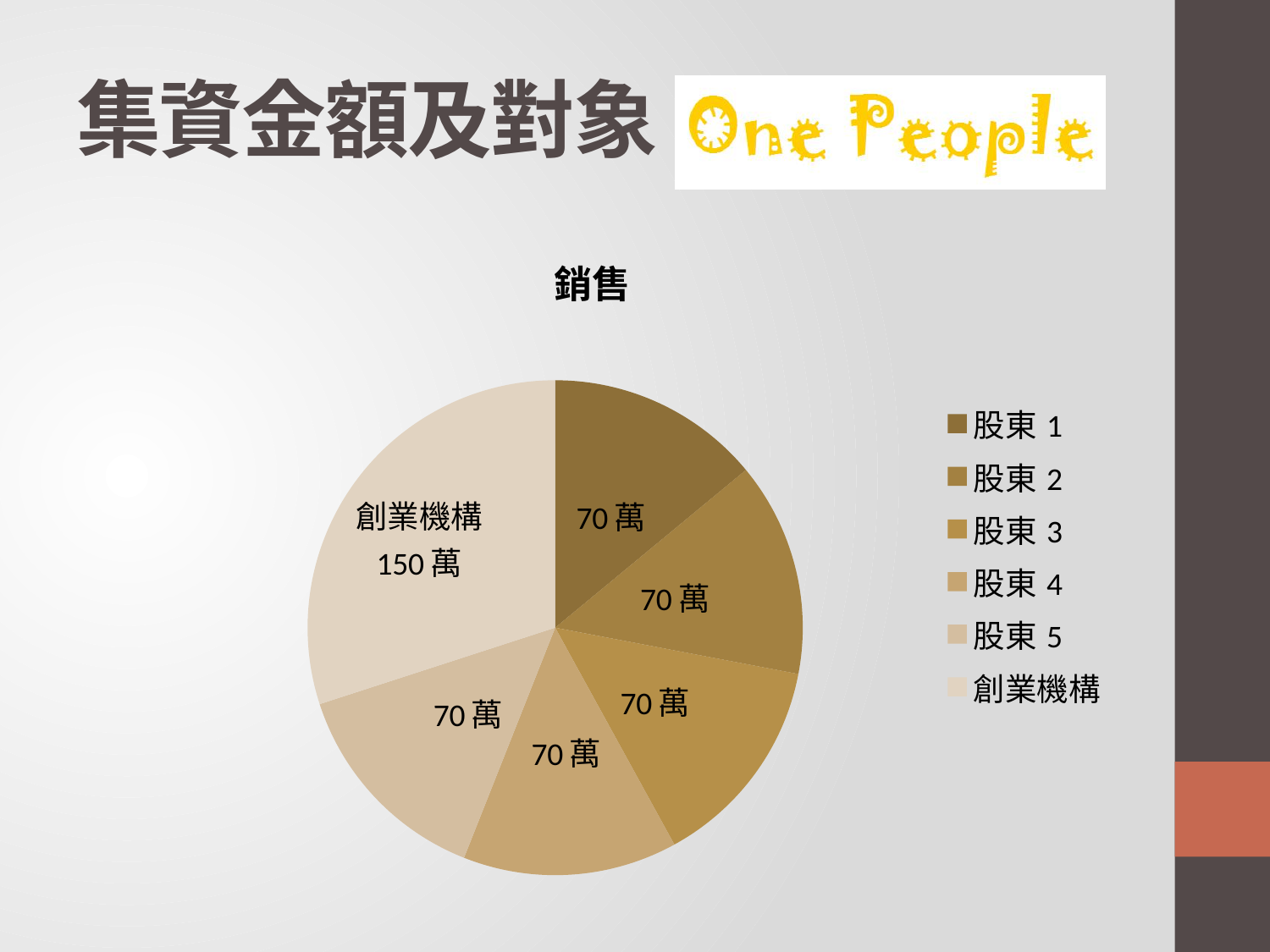
What is the difference between the value for 創業機構 and the value for 股東 3? 80 萬 How many slices does the pie chart have? 6 What is the value for 股東 1? 70 萬 What kind of chart is shown on the slide? pie chart How many entries does the legend list? 6 What is the title of the chart? 銷售 What share of the pie does 創業機構 represent? 30% Which is larger, the value for 創業機構 or the value for 股東 2? 創業機構 What is the value for 股東 5? 70 萬 Which category has the largest slice? 創業機構 What is the total of all slices in the pie chart? 500 萬 What is the value for 創業機構? 150 萬